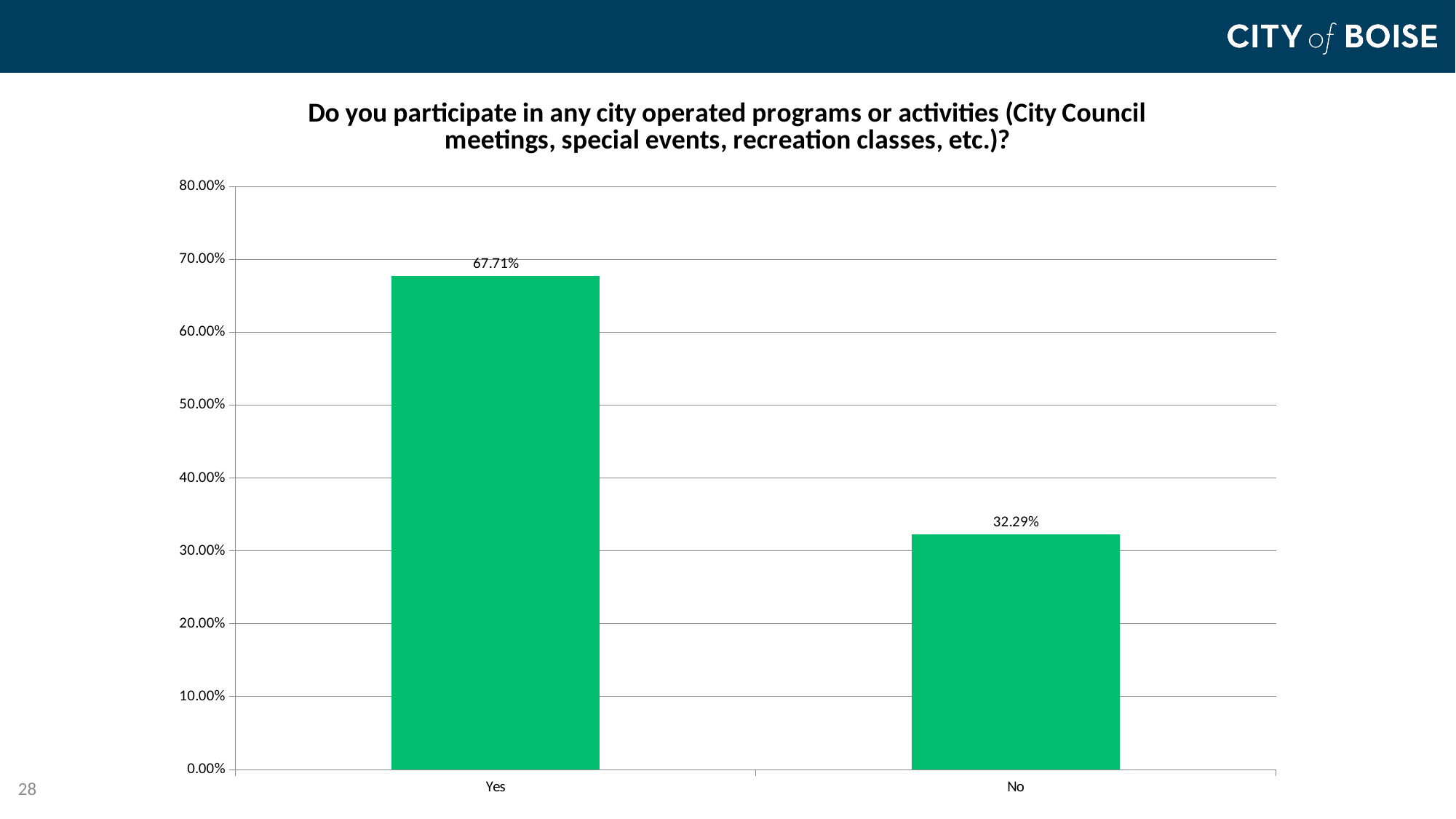
Which response has the highest value? Yes What colour are the bars in the chart? Green Is the value for Yes greater or less than 60.00%? greater Which is larger, the value for Yes or the value for No? Yes What is the difference in percentage points between the Yes and No responses? 35.42 Is the value for No greater or less than 40.00%? less What kind of chart is shown on the slide? Bar chart How many response categories are shown on the chart? 2 What is the highest value shown on the vertical axis? 80.00% What percentage of respondents answered Yes? 67.71% Which response has the lowest value? No What percentage of respondents answered No? 32.29%